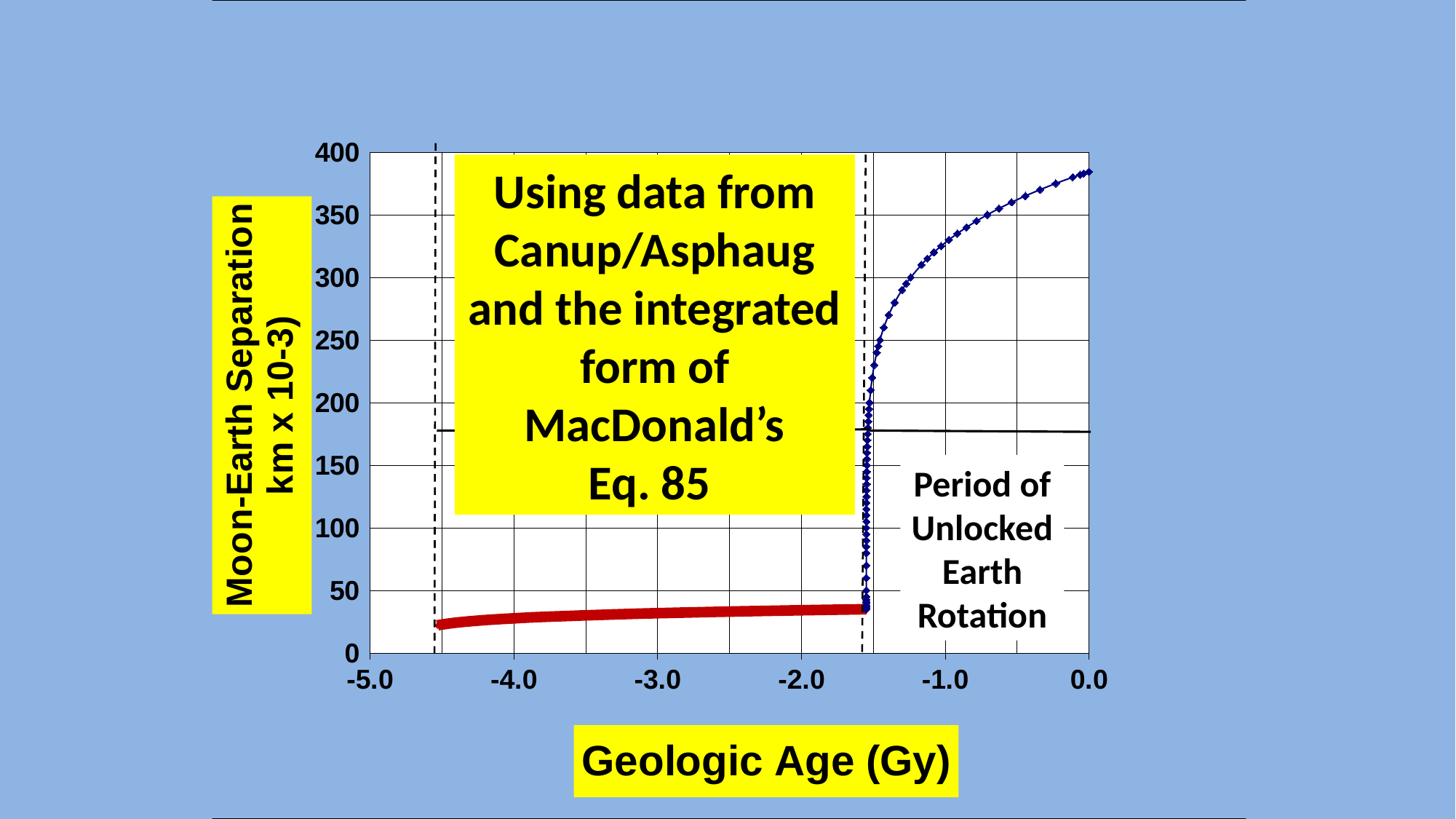
What kind of chart is shown on the slide? line chart Is the Moon-Earth separation at geologic age -2.0 greater or less than 100? less What is the label of the x axis? Geologic Age (Gy) Is the Moon-Earth separation at geologic age -4.0 greater or less than 50? less How many data series are plotted on the chart? 2 Is the Moon-Earth separation at geologic age -1.0 greater or less than 300? greater What is the highest value shown on the y axis? 400 Does the Moon-Earth separation rise or fall as geologic age moves from -5.0 toward 0.0? rise At which geologic age shown on the x axis is the Moon-Earth separation highest? 0.0 What is the label of the y axis? Moon-Earth Separation km x 10-3 Which has the larger Moon-Earth separation, geologic age -3.0 or geologic age -1.0? -1.0